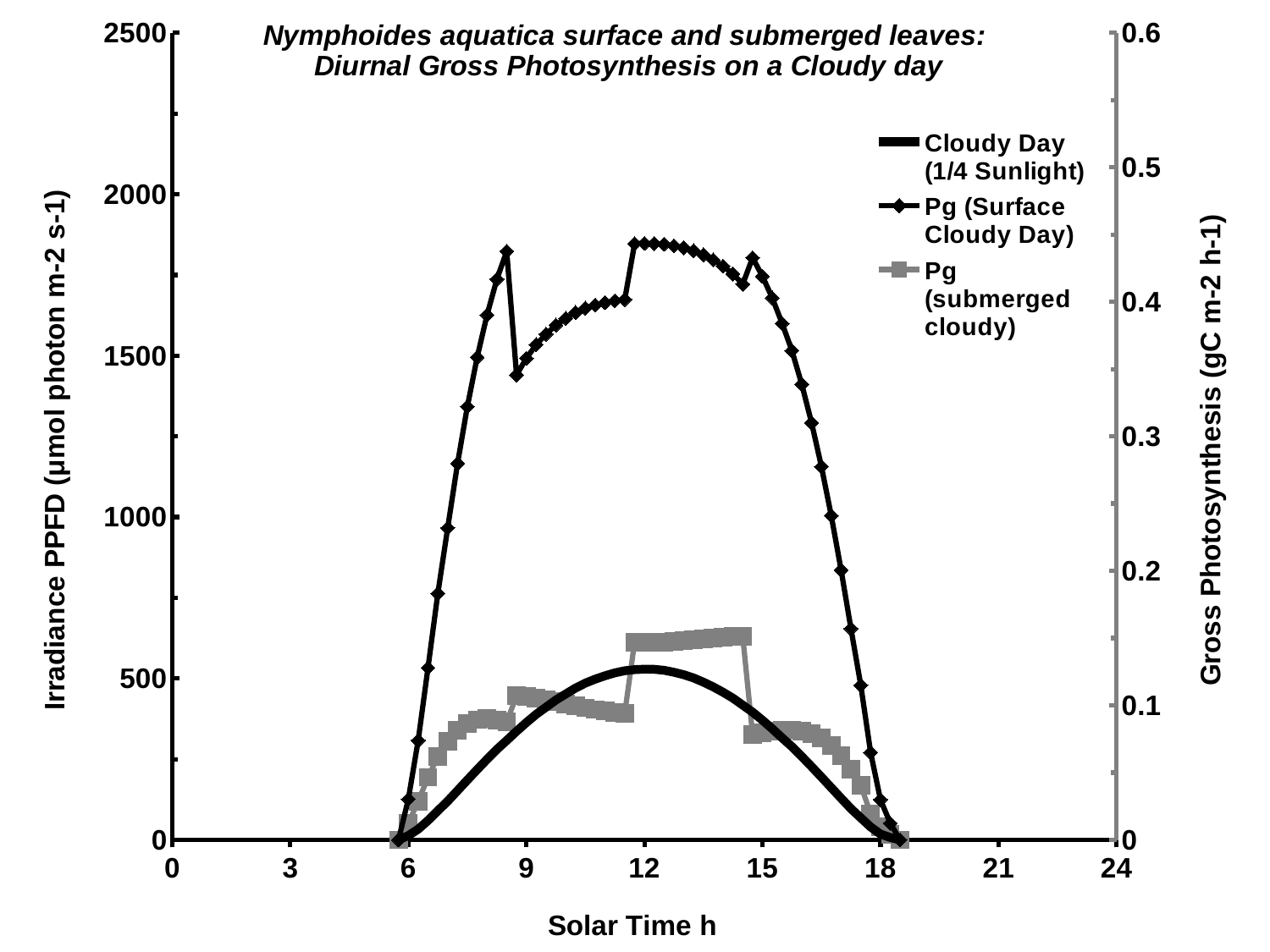
Is the peak value of the Pg (Surface Cloudy Day) series greater or less than 0.4 on the right axis? greater Is the peak value of the Pg (submerged cloudy) series greater or less than 0.2 on the right axis? less Does the Pg (Surface Cloudy Day) series rise or fall between 15 h and 18 h solar time? fall Which of the two Pg series reaches the highest gross photosynthesis value? Pg (Surface Cloudy Day) Does the Cloudy Day (1/4 Sunlight) irradiance curve rise or fall between 6 h and 12 h solar time? rise Is the peak value of the Cloudy Day (1/4 Sunlight) irradiance curve greater or less than 1000 on the left axis? less What is the title of the chart? Nymphoides aquatica surface and submerged leaves: Diurnal Gross Photosynthesis on a Cloudy day What kind of chart is shown on the slide? line chart What is the label of the x axis? Solar Time h At 12 h solar time, which series is higher: Pg (Surface Cloudy Day) or Pg (submerged cloudy)? Pg (Surface Cloudy Day) How many series does the legend list? 3